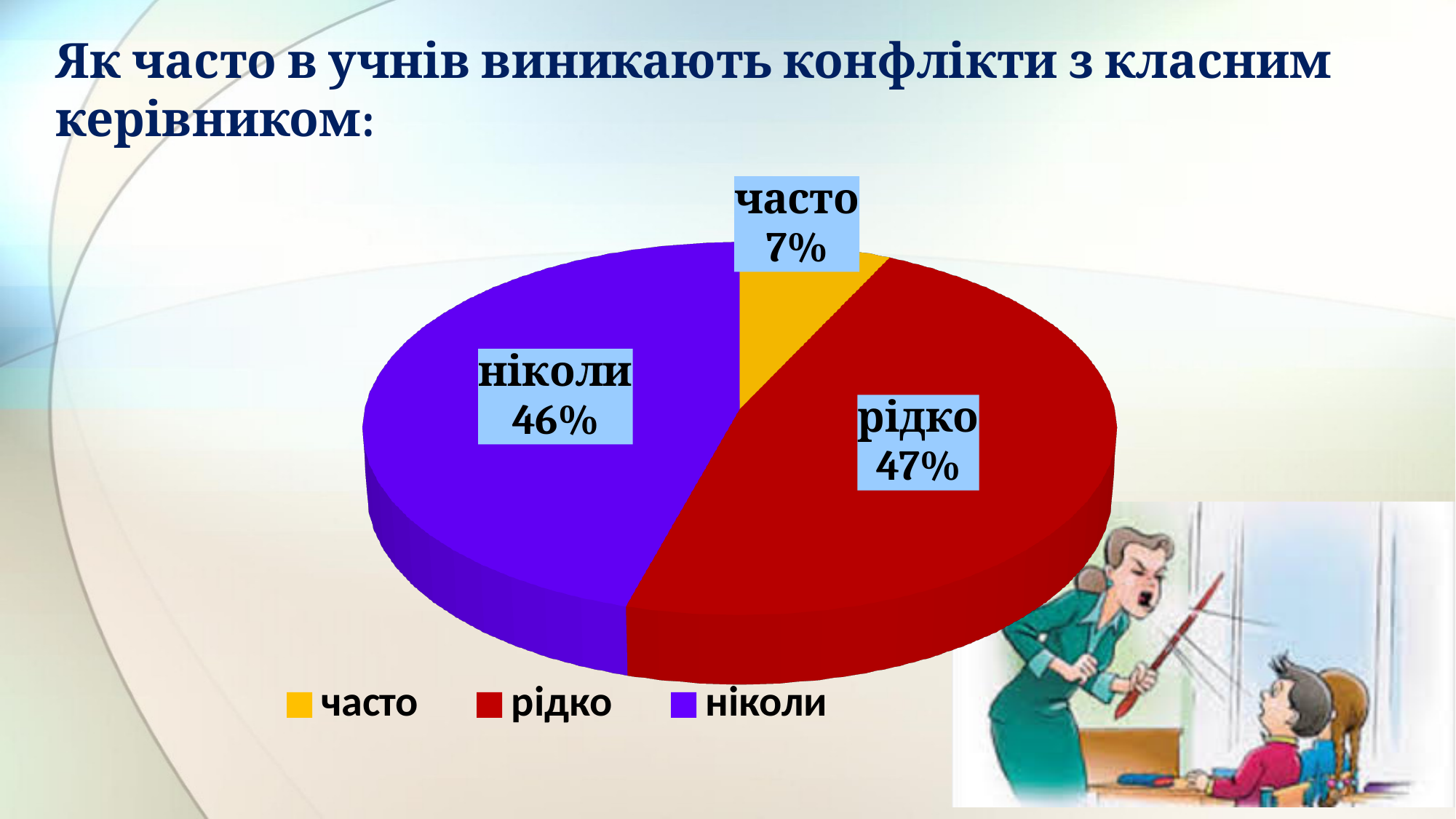
Which answer has the smallest share of the pie? часто Which is larger, the share for "рідко" or the share for "ніколи"? рідко What percentage of students answered "рідко"? 47% What is the difference in percentage points between "рідко" and "часто"? 40 What percentage of students answered "ніколи"? 46% How many entries does the legend list? 3 What colour is the slice for "ніколи"? purple What is the difference in percentage points between "ніколи" and "часто"? 39 What percentage of students answered "часто"? 7% What kind of chart is shown on the slide? pie chart How many slices does the pie chart have? 3 Which answer has the largest share of the pie? рідко